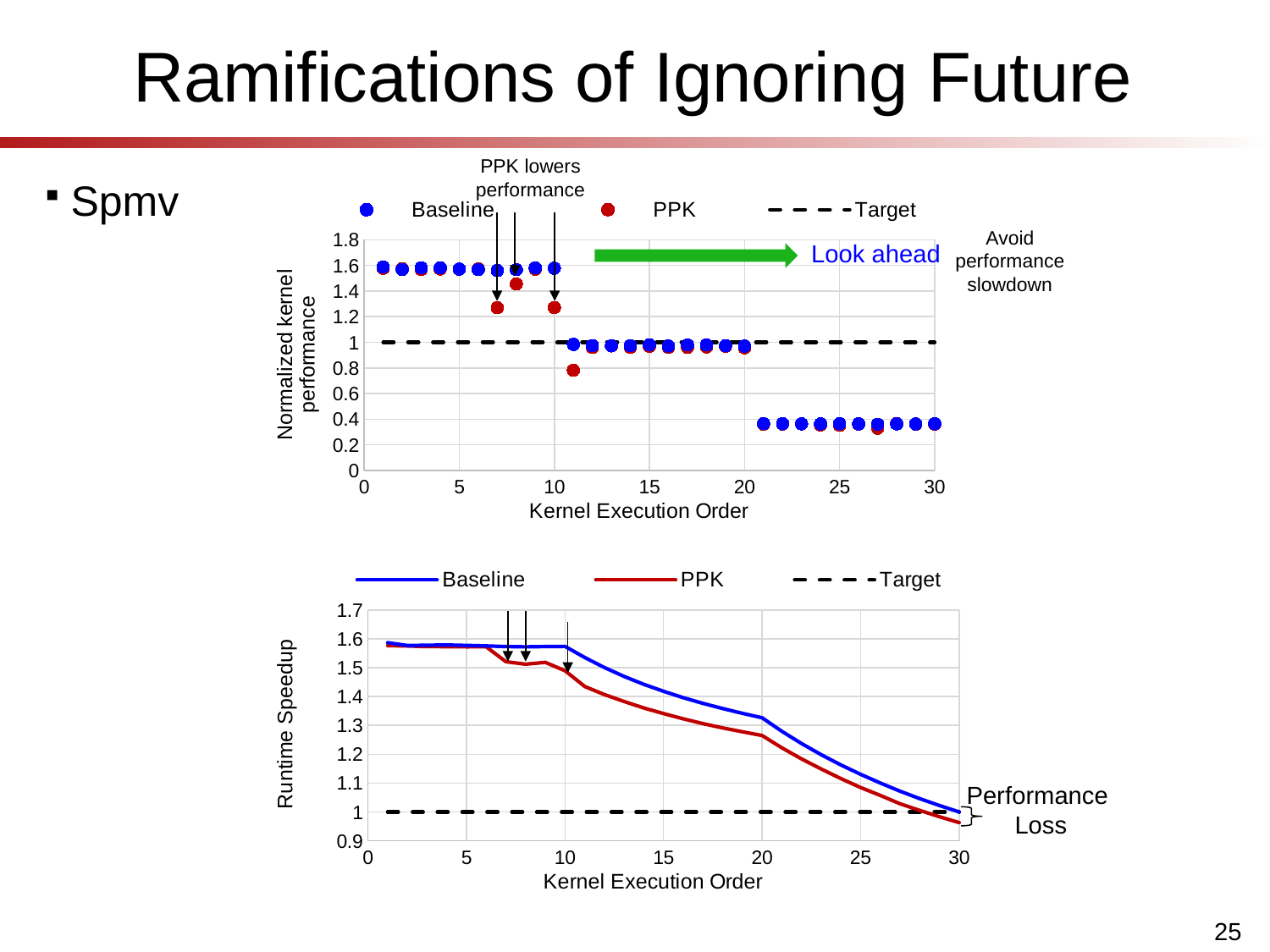
In the top chart, is the Baseline normalized kernel performance for kernel 25 greater or less than 0.6? less What is the x-axis label of the bottom chart? Kernel Execution Order In the bottom chart, how many series does the legend list? 3 In the top chart, how many series does the legend list? 3 What kind of chart is the bottom chart (Runtime Speedup)? line chart In the bottom chart, does the Baseline runtime speedup rise or fall as kernel execution order increases? fall In the bottom chart, at kernel execution order 20, which series has the higher runtime speedup, Baseline or PPK? Baseline In the top chart, at kernel execution order 11, which series has the higher normalized kernel performance, Baseline or PPK? Baseline What kind of chart is the top chart (Normalized kernel performance)? scatter chart In the top chart, is the Baseline normalized kernel performance for kernel 3 greater or less than 1.4? greater What is the y-axis label of the bottom chart? Runtime Speedup In the bottom chart, is the PPK runtime speedup at kernel execution order 30 greater or less than 1? less